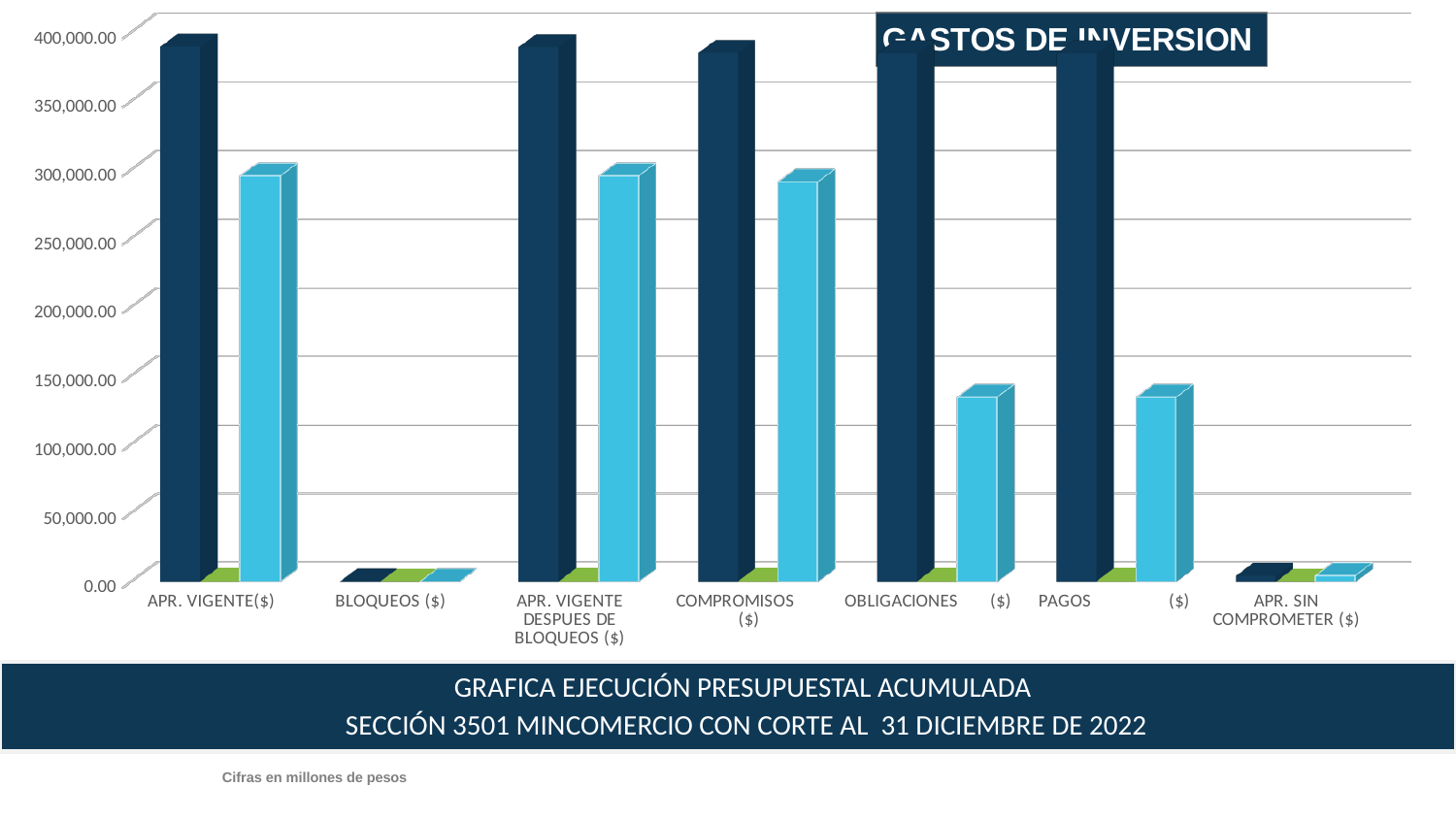
Is the value of the light blue bar for APR. VIGENTE($) greater or less than 250,000.00? greater What kind of chart is shown on the slide? bar chart Is the value of the dark blue bar for COMPROMISOS ($) greater or less than 300,000.00? greater Is the value of the dark blue bar for BLOQUEOS ($) greater or less than 50,000.00? less Which light blue bar is taller: APR. VIGENTE($) or OBLIGACIONES ($)? APR. VIGENTE($) Which dark blue bar is taller: APR. VIGENTE DESPUES DE BLOQUEOS ($) or APR. SIN COMPROMETER ($)? APR. VIGENTE DESPUES DE BLOQUEOS ($) How many categories are shown along the x axis of the chart? 7